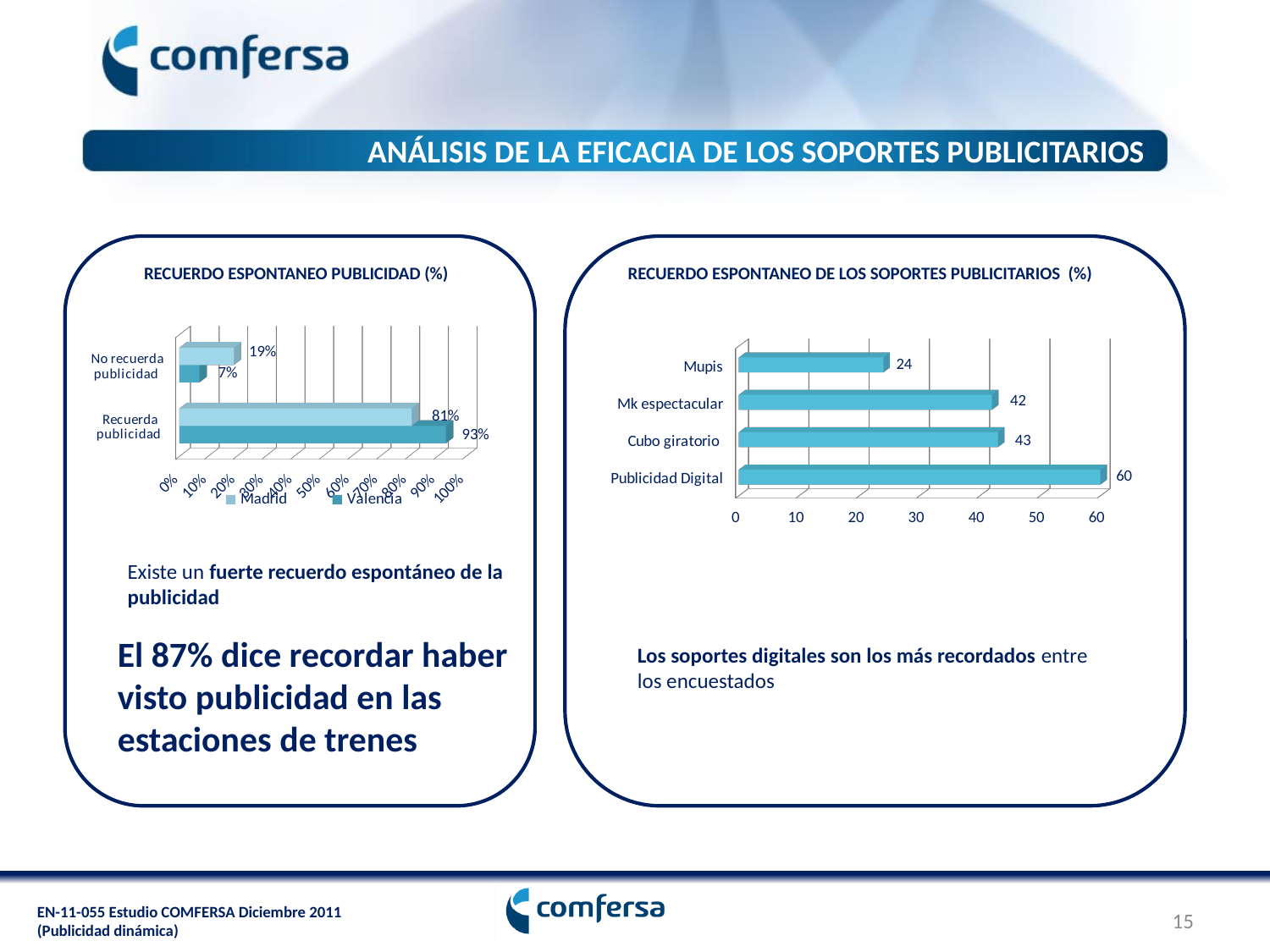
In the chart titled "RECUERDO ESPONTANEO PUBLICIDAD (%)", which is larger for "Recuerda publicidad": Madrid or Valencia? Valencia In the chart titled "RECUERDO ESPONTANEO PUBLICIDAD (%)", what is the difference between the Madrid and Valencia values for "No recuerda publicidad"? 12% In the chart titled "RECUERDO ESPONTANEO DE LOS SOPORTES PUBLICITARIOS (%)", which category has the lowest value? Mupis In the chart titled "RECUERDO ESPONTANEO PUBLICIDAD (%)", what is the Madrid value for "No recuerda publicidad"? 19% In the chart titled "RECUERDO ESPONTANEO DE LOS SOPORTES PUBLICITARIOS (%)", which category has the highest value? Publicidad Digital In the chart titled "RECUERDO ESPONTANEO PUBLICIDAD (%)", what is the Valencia value for "Recuerda publicidad"? 93% In the chart titled "RECUERDO ESPONTANEO DE LOS SOPORTES PUBLICITARIOS (%)", what is the value for Publicidad Digital? 60 How many series does the legend list in the chart titled "RECUERDO ESPONTANEO PUBLICIDAD (%)"? 2 In the chart titled "RECUERDO ESPONTANEO DE LOS SOPORTES PUBLICITARIOS (%)", how many categories are shown? 4 In the chart titled "RECUERDO ESPONTANEO DE LOS SOPORTES PUBLICITARIOS (%)", what is the value for Mupis? 24 In the chart titled "RECUERDO ESPONTANEO DE LOS SOPORTES PUBLICITARIOS (%)", what is the difference between the values for Publicidad Digital and Mupis? 36 What kind of chart is the one titled "RECUERDO ESPONTANEO DE LOS SOPORTES PUBLICITARIOS (%)"? Bar chart